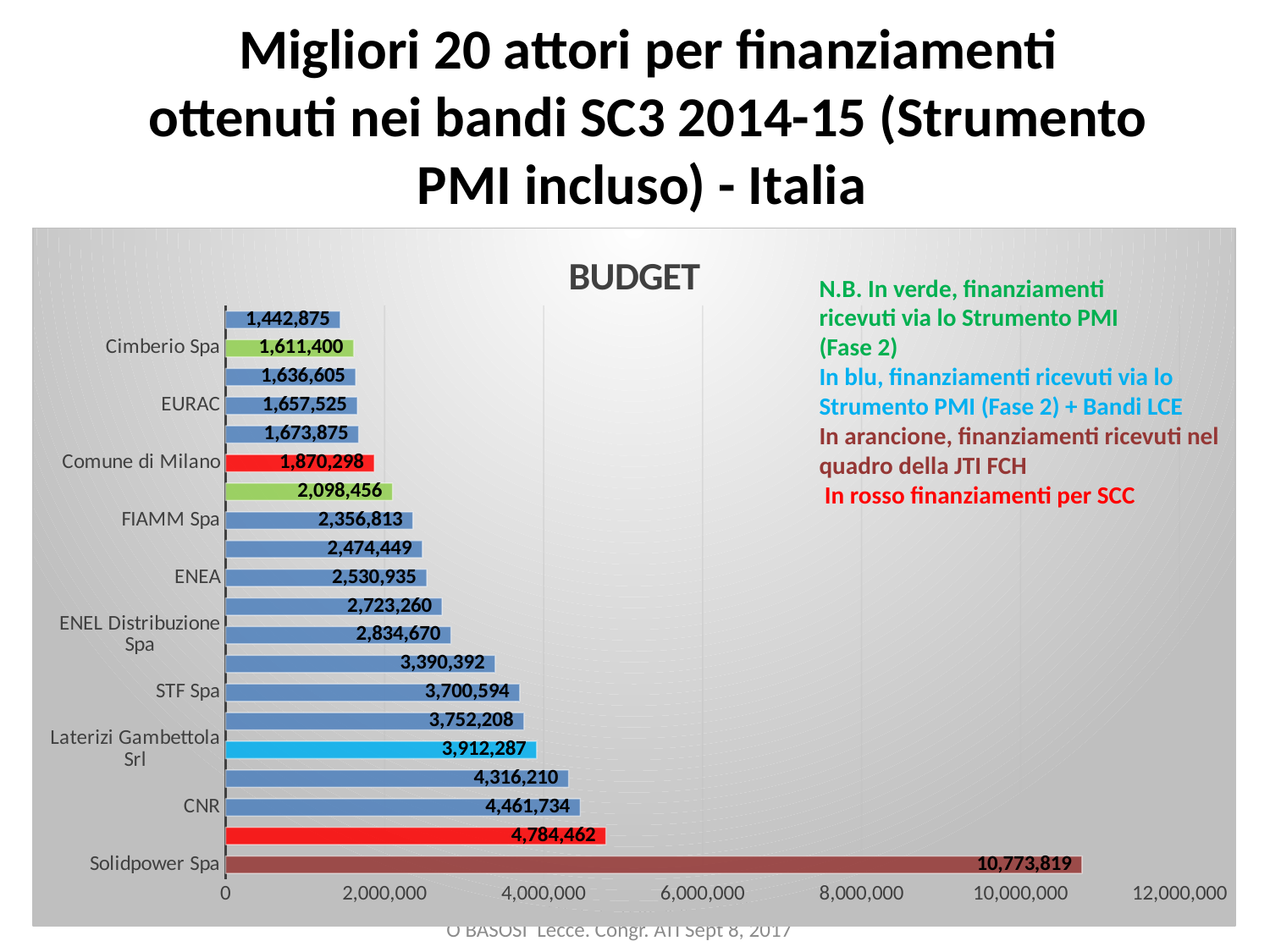
Which category has the highest value? Solidpower Spa Is the value for ENEL Distribuzione Spa greater or less than 2,000,000? greater What is the value for Cimberio Spa? 1,611,400 Which is larger, the value for ENEA or the value for FIAMM Spa? ENEA What is the value for Comune di Milano? 1,870,298 How many bars are plotted in the chart? 20 What kind of chart is shown on the slide? Bar chart What is the value for Laterizi Gambettola Srl? 3,912,287 What is the difference between the values for CNR and STF Spa? 761,140 What is the title of the chart? BUDGET What is the value for CNR? 4,461,734 What is the value for Solidpower Spa? 10,773,819